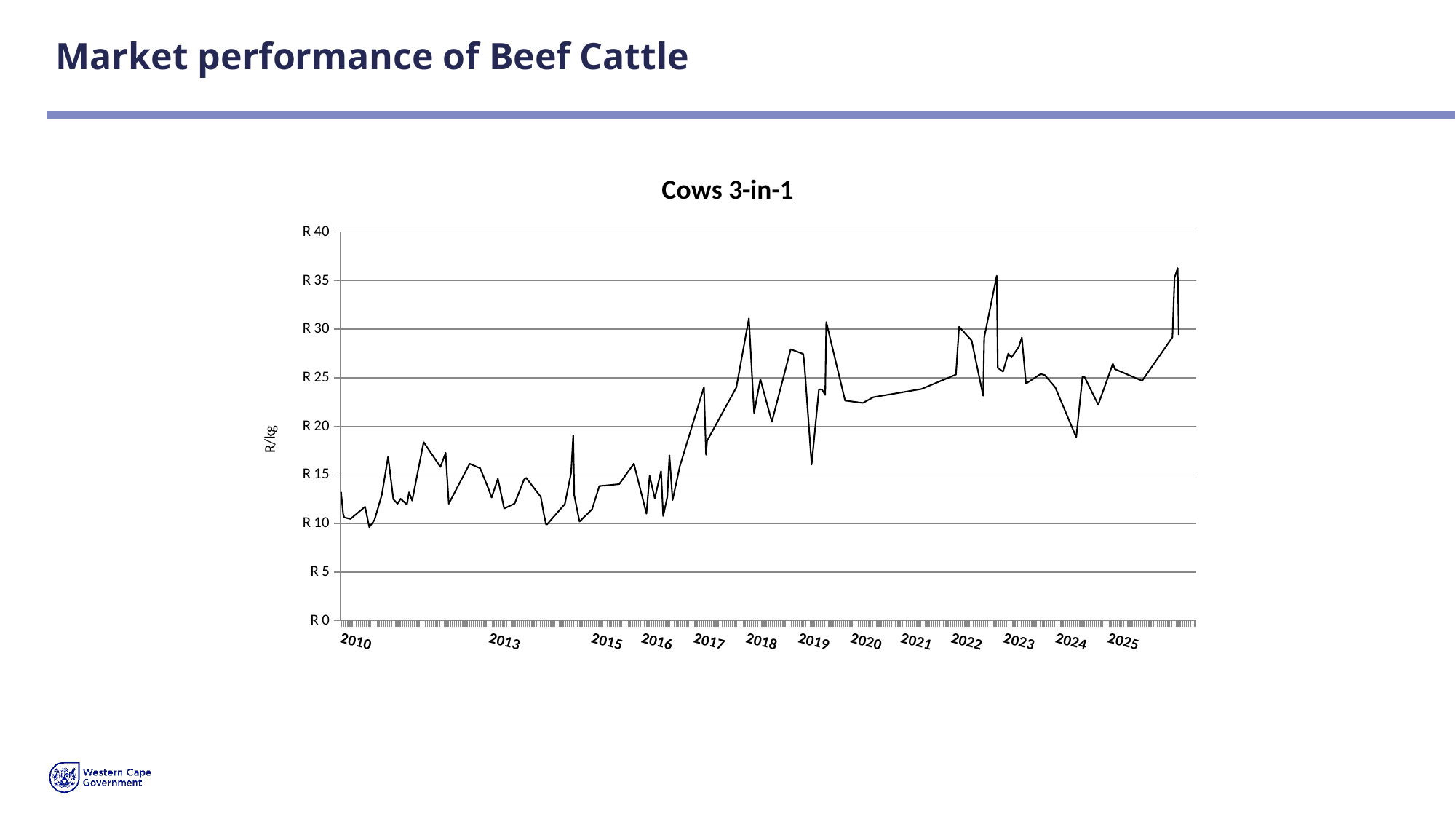
Are the values plotted during 2013 greater or less than R 20? less How many lines are plotted on the chart? 1 Are the values plotted during 2020 greater or less than R 20? greater Overall, do the values rise or fall from 2010 to 2025? rise Is the highest value plotted on the chart greater or less than R 30? greater What is the highest value shown on the vertical axis? R 40 What is the label on the vertical axis of the chart? R/kg What is the title of the chart? Cows 3-in-1 What kind of chart is shown on the slide? line chart